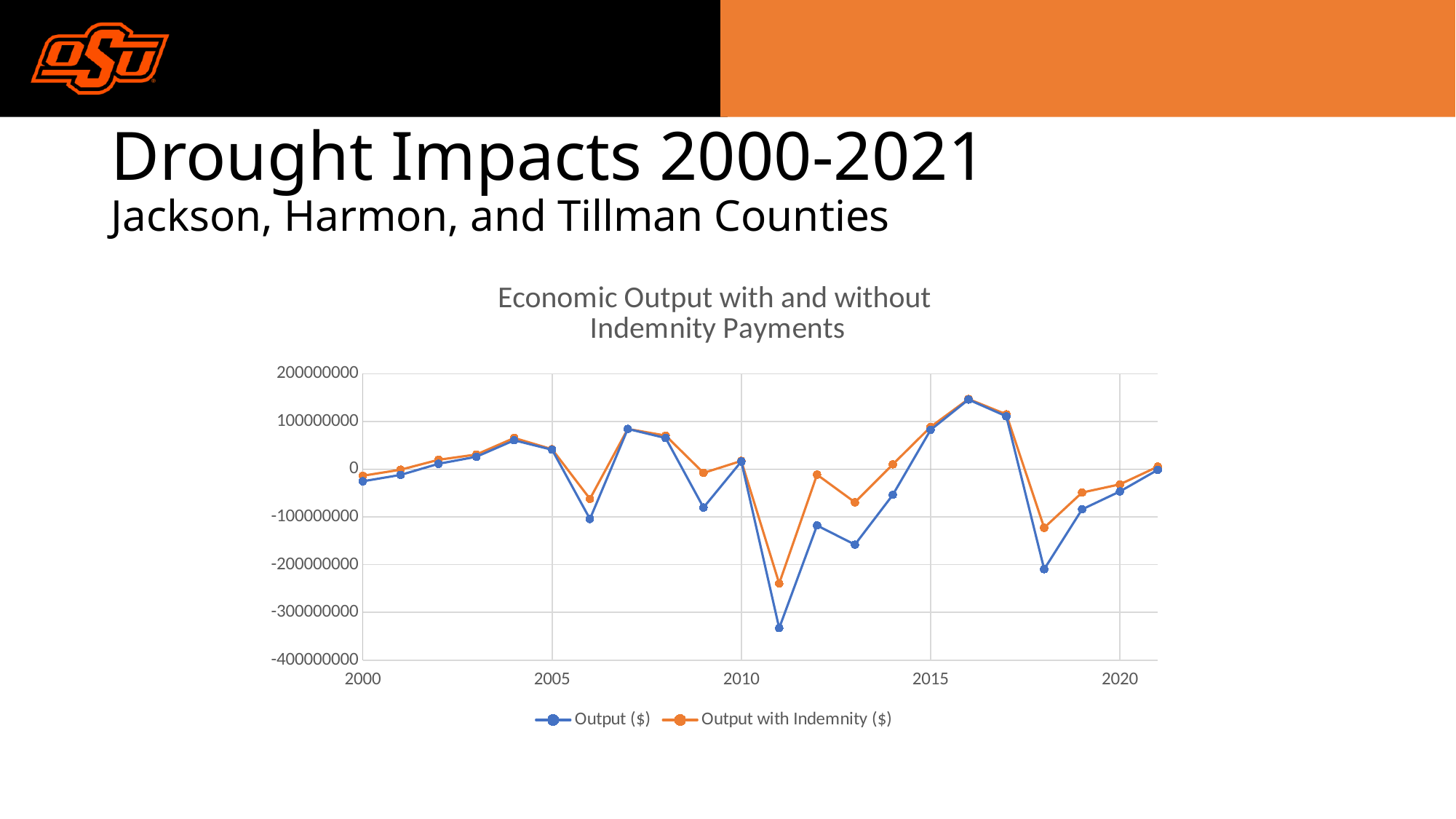
In which year does the Output with Indemnity ($) series reach its lowest value? 2011 Is the value for Output ($) in 2011 greater or less than -300000000? less How many yearly data points does each series have? 22 What kind of chart is shown on the slide? line chart Is the value for Output ($) in 2013 greater or less than -100000000? less In 2018, which series has the larger value, Output ($) or Output with Indemnity ($)? Output with Indemnity ($) How many series does the legend list? 2 In which year does the Output ($) series reach its lowest value? 2011 Is the value for Output with Indemnity ($) in 2011 greater or less than -200000000? less In which year does the Output ($) series reach its highest value? 2016 What is the title of the chart? Economic Output with and without Indemnity Payments